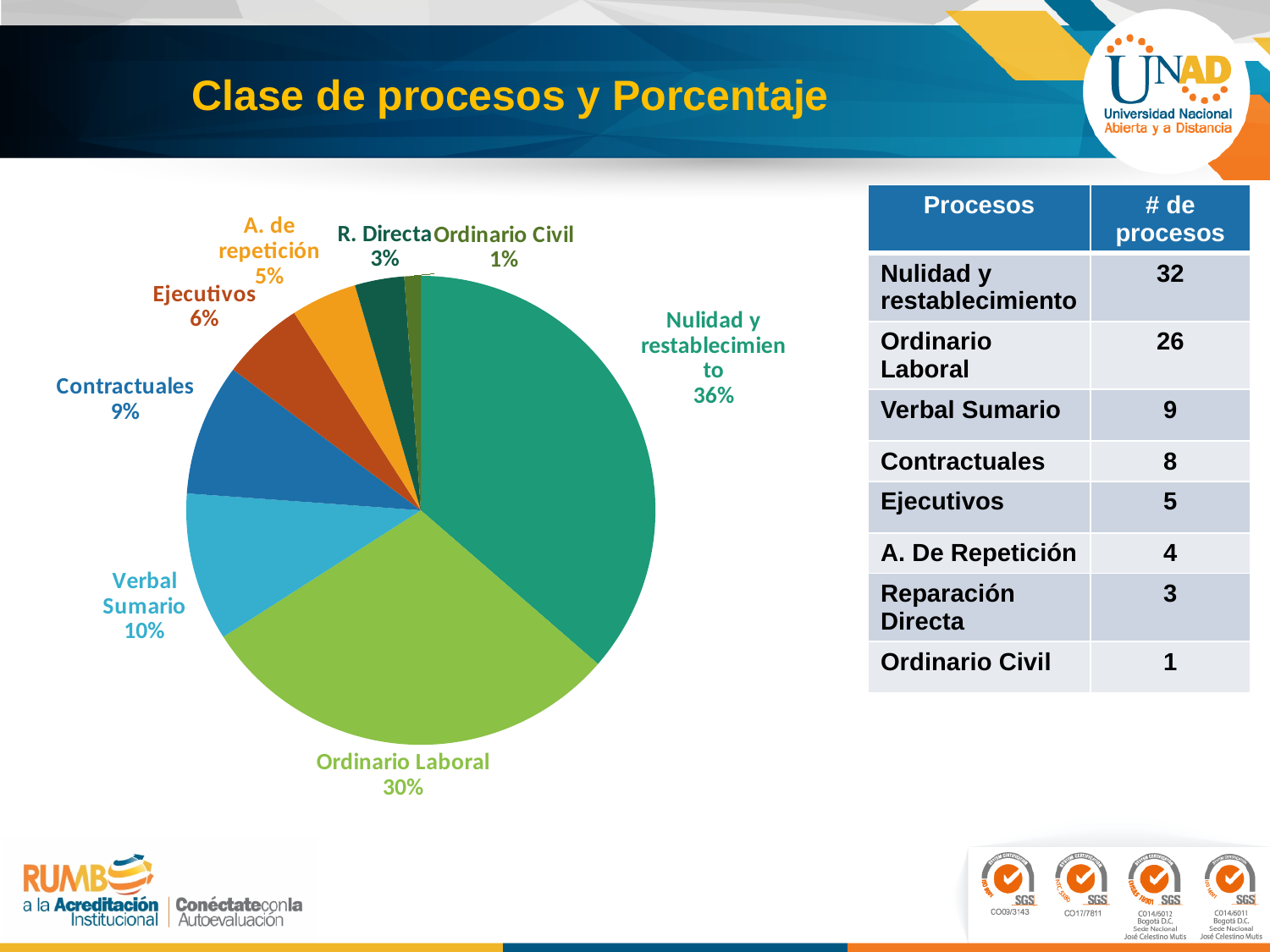
Which slice is larger in the pie chart, Verbal Sumario or Contractuales? Verbal Sumario Which category has the largest slice in the pie chart? Nulidad y restablecimiento What is the title of the slide containing the pie chart? Clase de procesos y Porcentaje What percentage does the pie chart show for Ordinario Laboral? 30% What kind of chart is shown on the slide? pie chart What percentage does the pie chart show for Nulidad y restablecimiento? 36% What percentage does the pie chart show for Contractuales? 9% What percentage does the pie chart show for Verbal Sumario? 10% How many slices does the pie chart have? 8 Which category has the smallest slice in the pie chart? Ordinario Civil What is the difference in percentage points between Nulidad y restablecimiento and Ordinario Laboral in the pie chart? 6 What percentage does the pie chart show for Ejecutivos? 6%